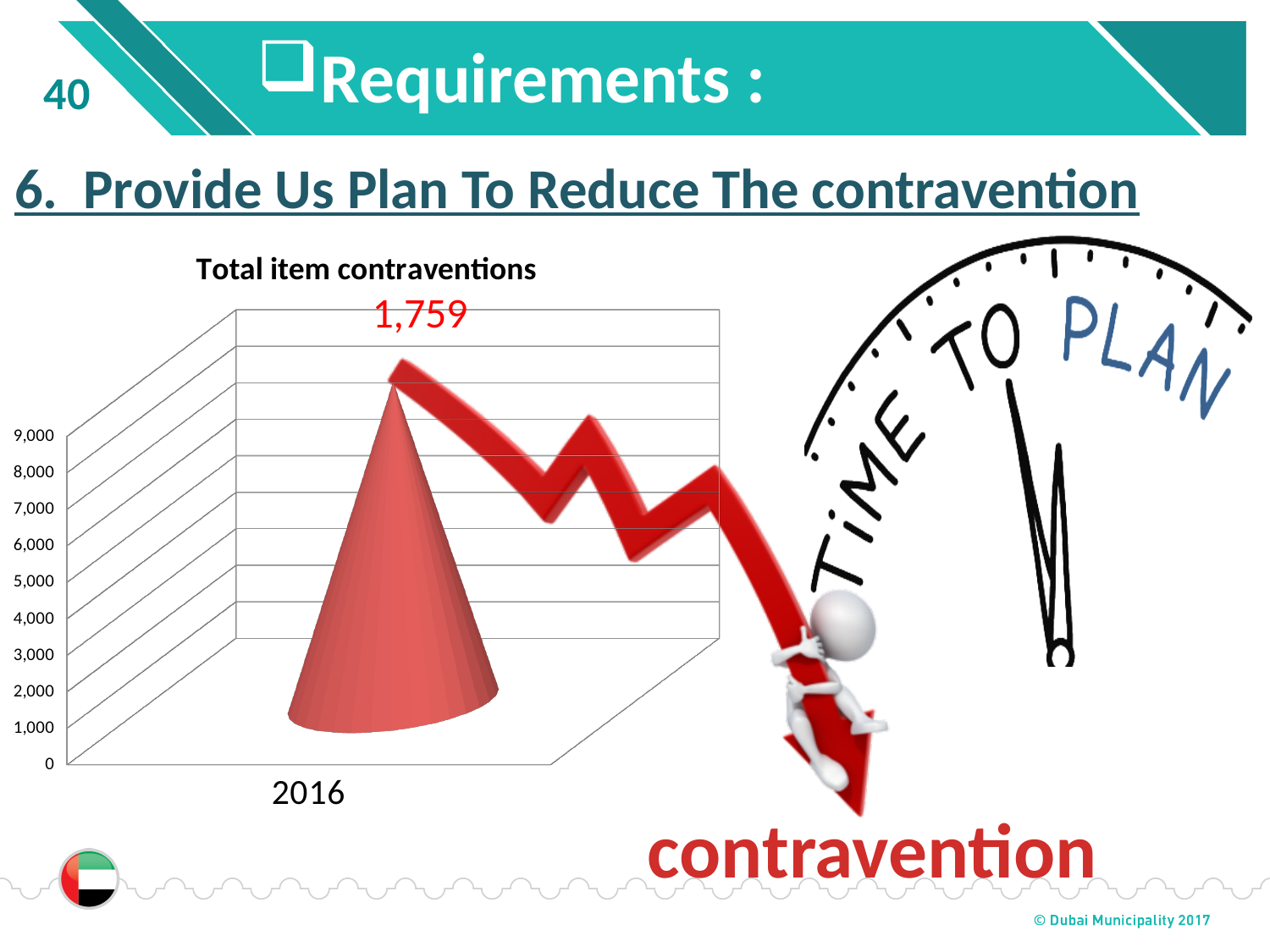
What is the lowest tick value shown on the y axis of the Total item contraventions chart? 0 How many categories are plotted on the x axis of the Total item contraventions chart? 1 Which year is shown on the x axis of the Total item contraventions chart? 2016 What is the title of the chart on the slide? Total item contraventions What kind of chart is the Total item contraventions chart? bar chart What is the data label printed above the bar in the Total item contraventions chart? 1,759 What is the highest tick value shown on the y axis of the Total item contraventions chart? 9,000